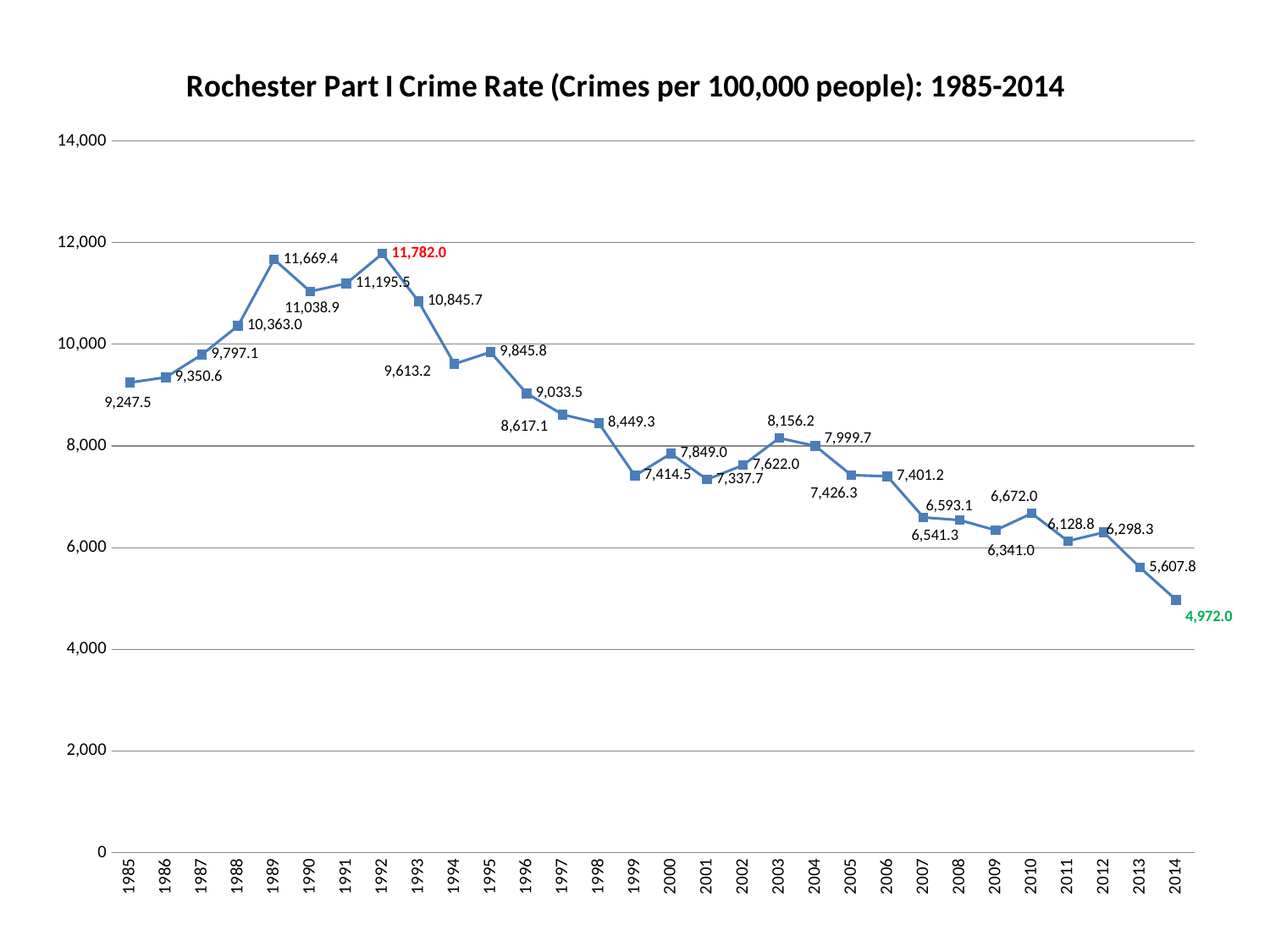
How many years are plotted on the chart? 30 Which year had the highest Part I crime rate? 1992 Does the crime rate generally rise or fall from 1992 to 2014? Fall What was the Rochester Part I crime rate in 1992? 11,782.0 What is the difference between the crime rate in 1992 and the crime rate in 2014? 6,810.0 Which year had the lowest Part I crime rate? 2014 What was the Rochester Part I crime rate in 1985? 9,247.5 Is the crime rate for 1989 greater or less than 10,000? greater Which year had a higher crime rate, 2003 or 2004? 2003 What colour is the data label for the 2014 value? Green What was the Rochester Part I crime rate in 2014? 4,972.0 What kind of chart is shown on the slide? Line chart